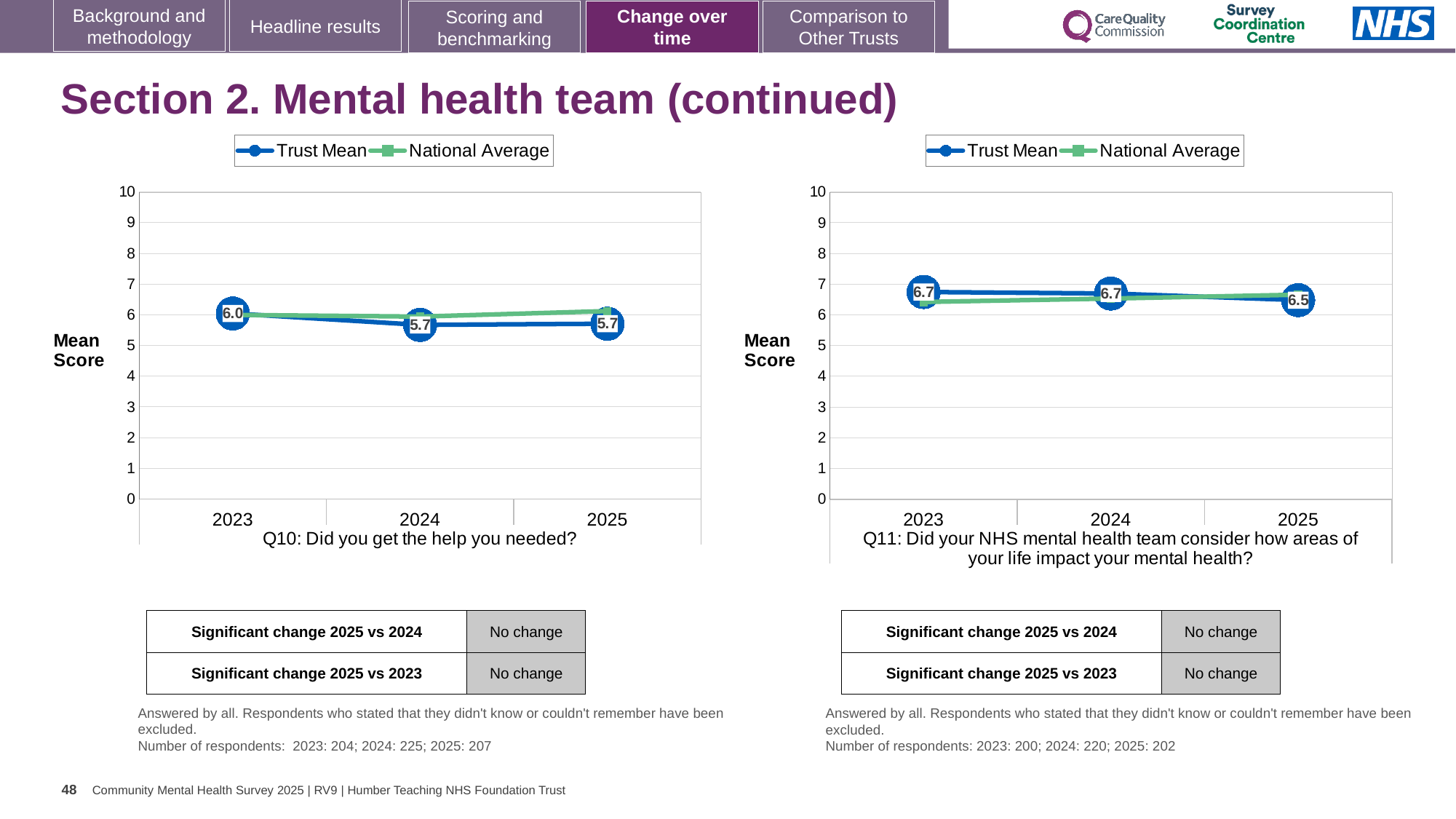
In the Q10 chart on the left, what is the Trust Mean for 2023? 6.0 In the Q10 chart on the left, what is the Trust Mean for 2025? 5.7 In the Q11 chart on the right, what is the Trust Mean for 2025? 6.5 In the Q10 chart on the left, is the National Average for 2025 greater or less than 5? greater In the Q11 chart on the right, is the Trust Mean for 2023 larger or smaller than the Trust Mean for 2025? larger In the Q11 chart on the right, which year has the lowest Trust Mean? 2025 How many years are plotted on the x axis of the Q11 chart on the right? 3 What kind of chart is the Q11 chart on the right? Line chart How many series does the legend of the Q10 chart on the left list? 2 In the Q10 chart on the left, which year has the highest Trust Mean? 2023 In the Q11 chart on the right, what is the Trust Mean for 2024? 6.7 In the Q10 chart on the left, what is the difference between the Trust Mean for 2023 and the Trust Mean for 2024? 0.3